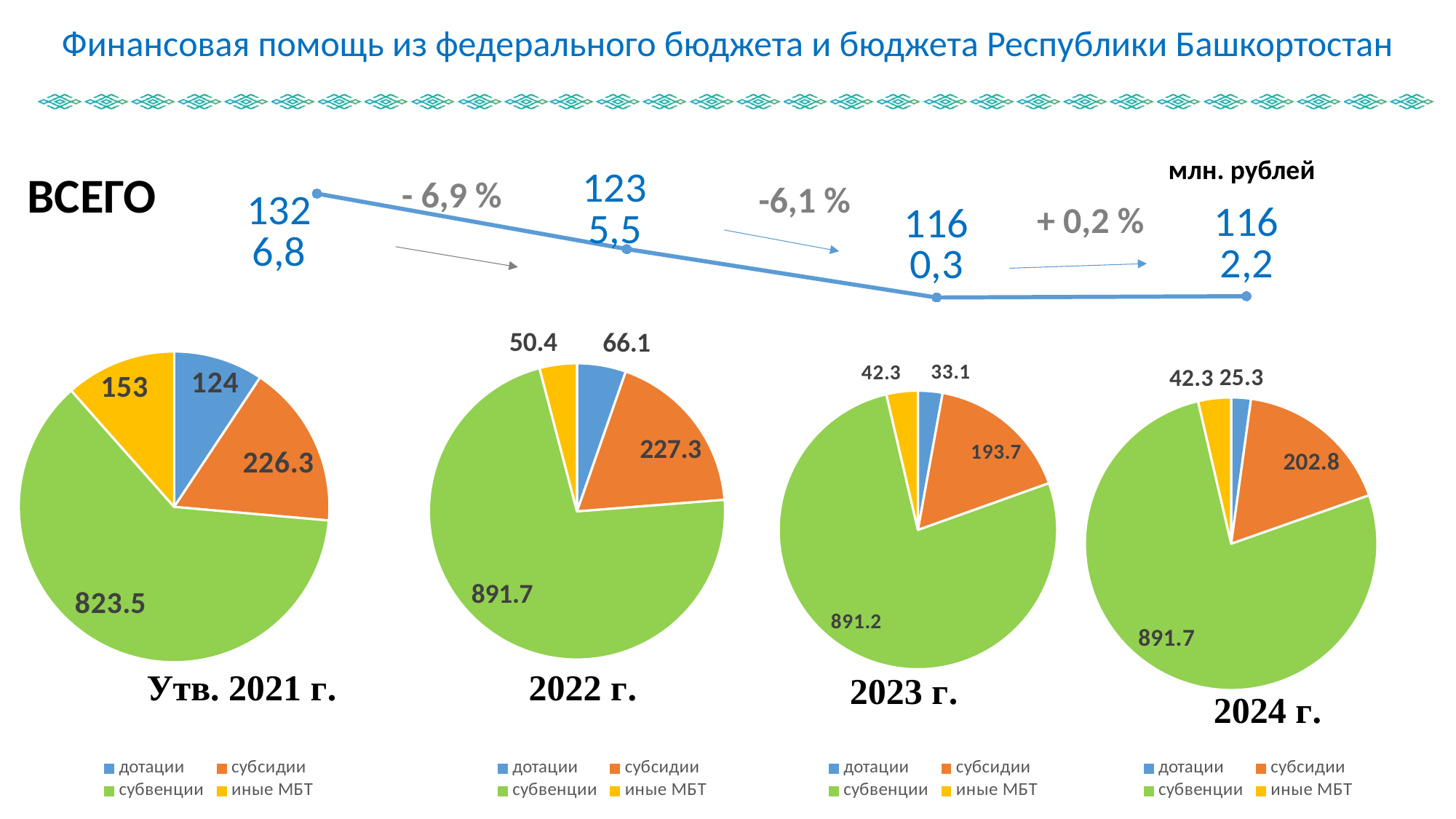
In the pie chart for 2022 г., what is the value for дотации? 66.1 In the pie chart for Утв. 2021 г., which category has the largest slice? субвенции What type of chart is the ВСЕГО chart at the top of the slide? line chart How many categories does each pie chart's legend list? 4 In the ВСЕГО line chart, what percentage change is labelled between 2023 and 2024? + 0,2 % Which is larger: субсидии in the 2022 г. pie chart or субсидии in the Утв. 2021 г. pie chart? 2022 г. In the pie chart for Утв. 2021 г., what is the value for субвенции? 823.5 In the pie chart for 2023 г., what is the value for субсидии? 193.7 In the pie chart for 2023 г., what is the difference between субсидии and иные МБТ? 151.4 In the pie chart for 2024 г., what is the value for иные МБТ? 42.3 In the pie chart for 2024 г., which category has the smallest slice? дотации How many pie charts are shown on the slide? 4